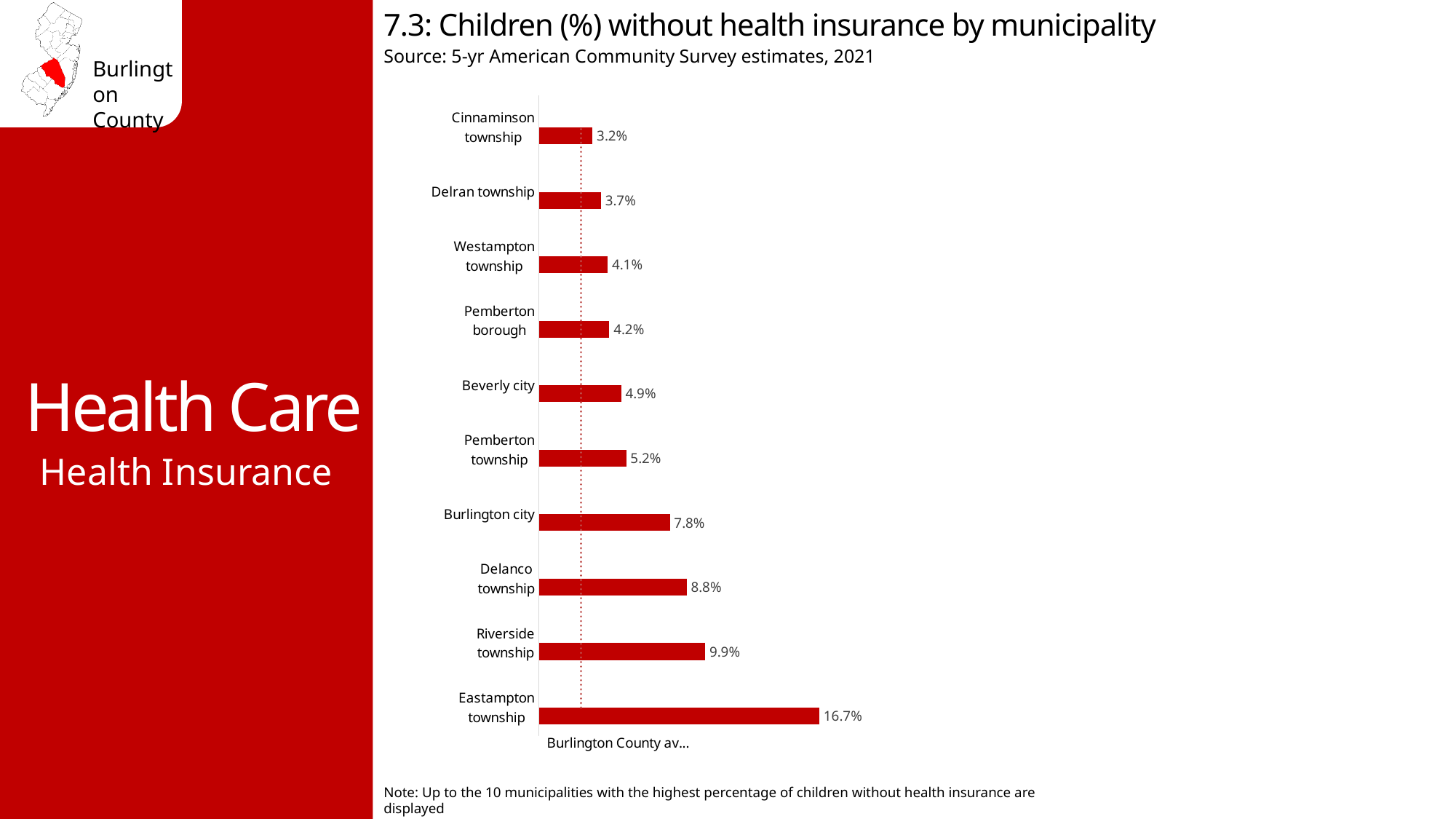
Which has a higher value, Riverside township or Delanco township? Riverside township What is the value shown for Burlington city? 7.8% How many municipalities are shown in the chart? 10 What kind of chart is shown on the slide? Bar chart What is the difference between the values for Delanco township and Beverly city? 3.9% What percentage is shown for Delran township? 3.7% What is the source of the data shown in the chart? 5-yr American Community Survey estimates, 2021 Which municipality has the highest percentage of children without health insurance? Eastampton township Which has a higher value, Pemberton township or Westampton township? Pemberton township What percentage of children are without health insurance in Eastampton township? 16.7% Which municipality has the lowest percentage of children without health insurance? Cinnaminson township What is the difference between the values for Eastampton township and Riverside township? 6.8%